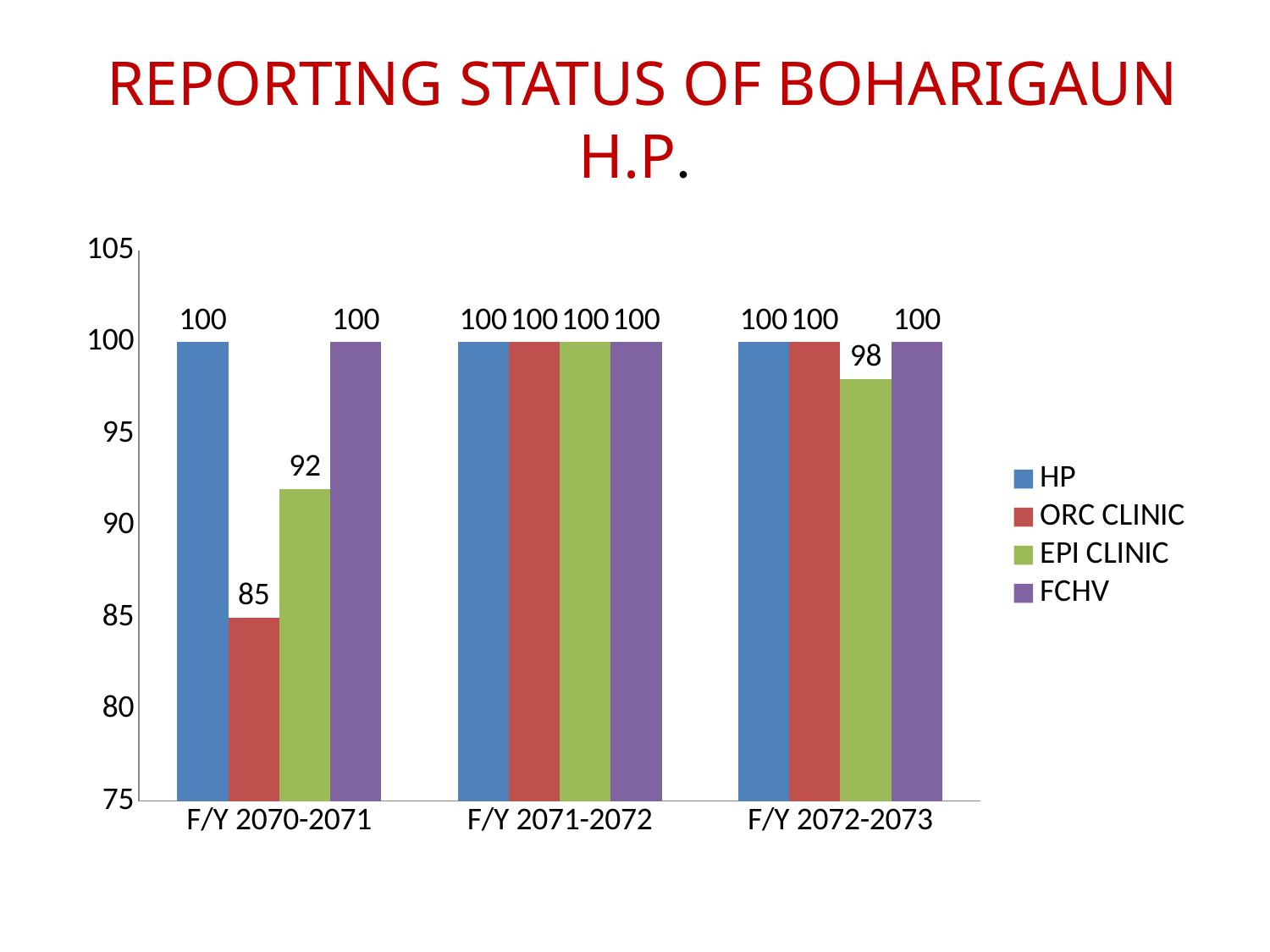
How many series does the legend list? 4 Which series has the lowest value in F/Y 2070-2071? ORC CLINIC What is the difference between the EPI CLINIC and ORC CLINIC values in F/Y 2070-2071? 7 What is the value for EPI CLINIC in F/Y 2072-2073? 98 Does the value for ORC CLINIC rise or fall from F/Y 2070-2071 to F/Y 2071-2072? Rise What kind of chart is shown on the slide? Bar chart What is the value for ORC CLINIC in F/Y 2070-2071? 85 What is the value for EPI CLINIC in F/Y 2070-2071? 92 Which is larger in F/Y 2070-2071: the value for EPI CLINIC or the value for ORC CLINIC? EPI CLINIC What is the value for HP in F/Y 2071-2072? 100 Which series has the lowest value in F/Y 2072-2073? EPI CLINIC How many fiscal year categories are shown on the x axis? 3